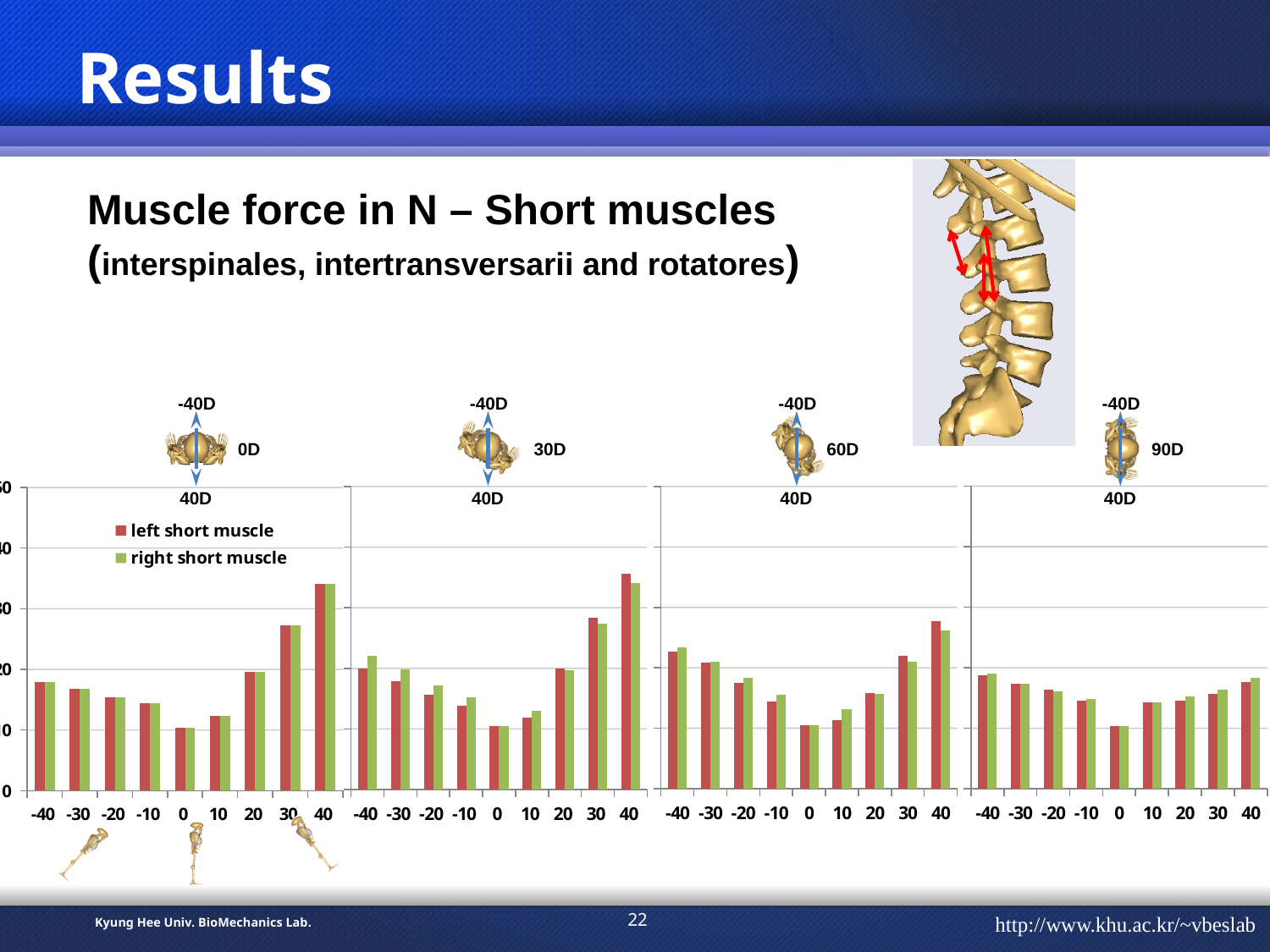
In the 0D chart, at which x-axis value is the left short muscle force highest? 40 In the 60D chart, at which x-axis value is the left short muscle force highest? 40 In the 0D chart, which is larger for the left short muscle: the value at 30 or the value at 20? 30 How many x-axis categories does the 0D chart have? 9 In the 0D chart, at which x-axis value is the left short muscle force lowest? 0 In the 0D chart, is the left short muscle value at 0 greater or less than 20? less In the 0D chart, is the left short muscle value at 40 greater or less than 30? greater How many series does the legend list? 2 In the 90D chart, at which x-axis value is the left short muscle force lowest? 0 What kind of chart is used in the 0D panel? bar chart In the 30D chart, at which x-axis value is the left short muscle force highest? 40 What are the two series named in the legend? left short muscle, right short muscle